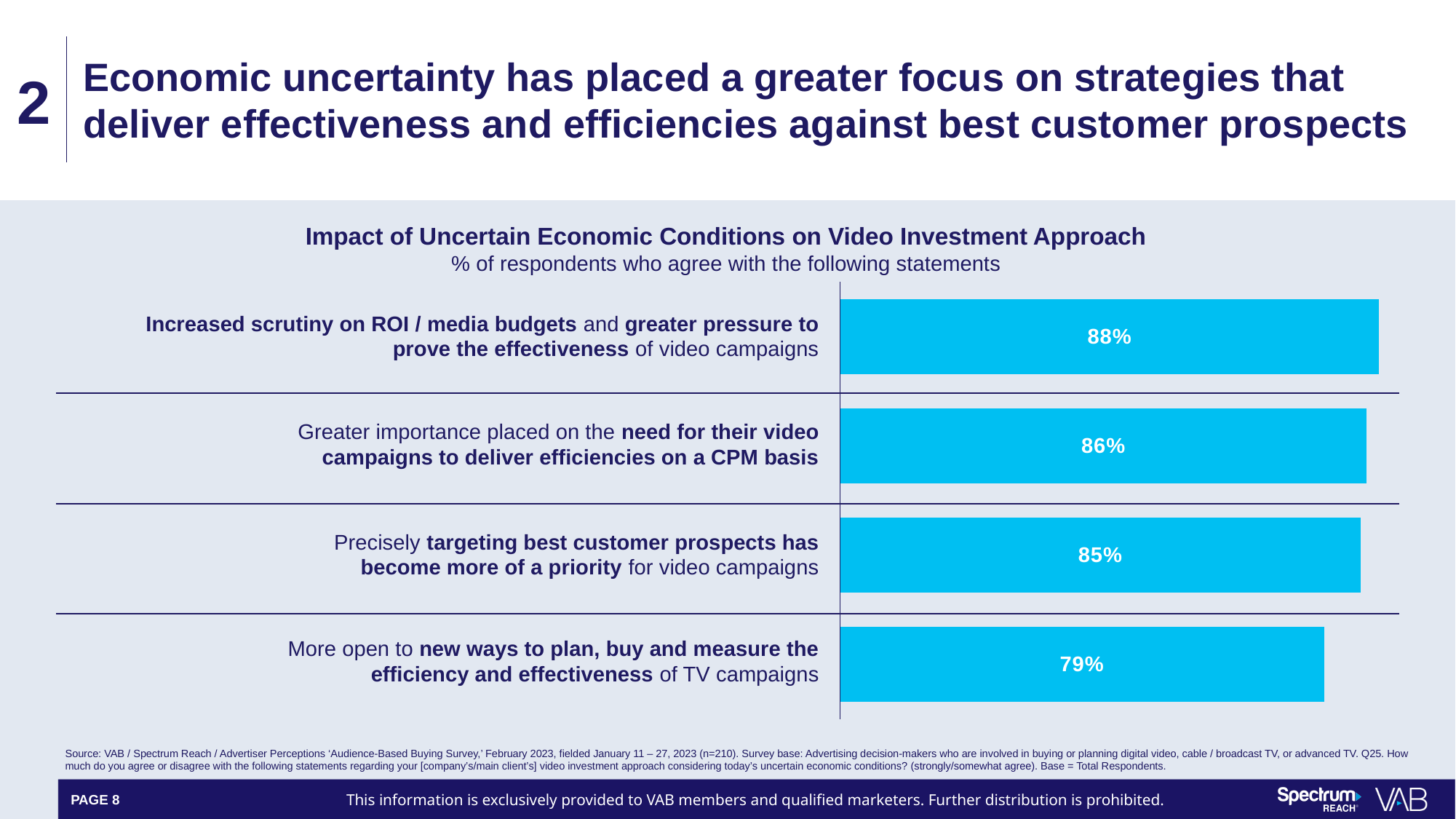
What is the title of the chart? Impact of Uncertain Economic Conditions on Video Investment Approach How many statements are shown in the chart? 4 Which statement has the highest share of respondents agreeing? Increased scrutiny on ROI / media budgets and greater pressure to prove the effectiveness of video campaigns What type of chart is used on this slide? Bar chart What percentage of respondents agree that precisely targeting best customer prospects has become more of a priority for video campaigns? 85% What percentage of respondents agree they are more open to new ways to plan, buy and measure the efficiency and effectiveness of TV campaigns? 79% Do the values rise or fall going from the top bar to the bottom bar? Fall What is the difference between the share agreeing with the CPM efficiencies statement and the share agreeing with the targeting best customer prospects statement? 1 percentage point What percentage of respondents agree that greater importance is placed on the need for their video campaigns to deliver efficiencies on a CPM basis? 86% What percentage of respondents agree that there is increased scrutiny on ROI / media budgets and greater pressure to prove the effectiveness of video campaigns? 88% Which statement has the lowest share of respondents agreeing? More open to new ways to plan, buy and measure the efficiency and effectiveness of TV campaigns What is the difference in percentage points between the highest and lowest values shown in the chart? 9 percentage points